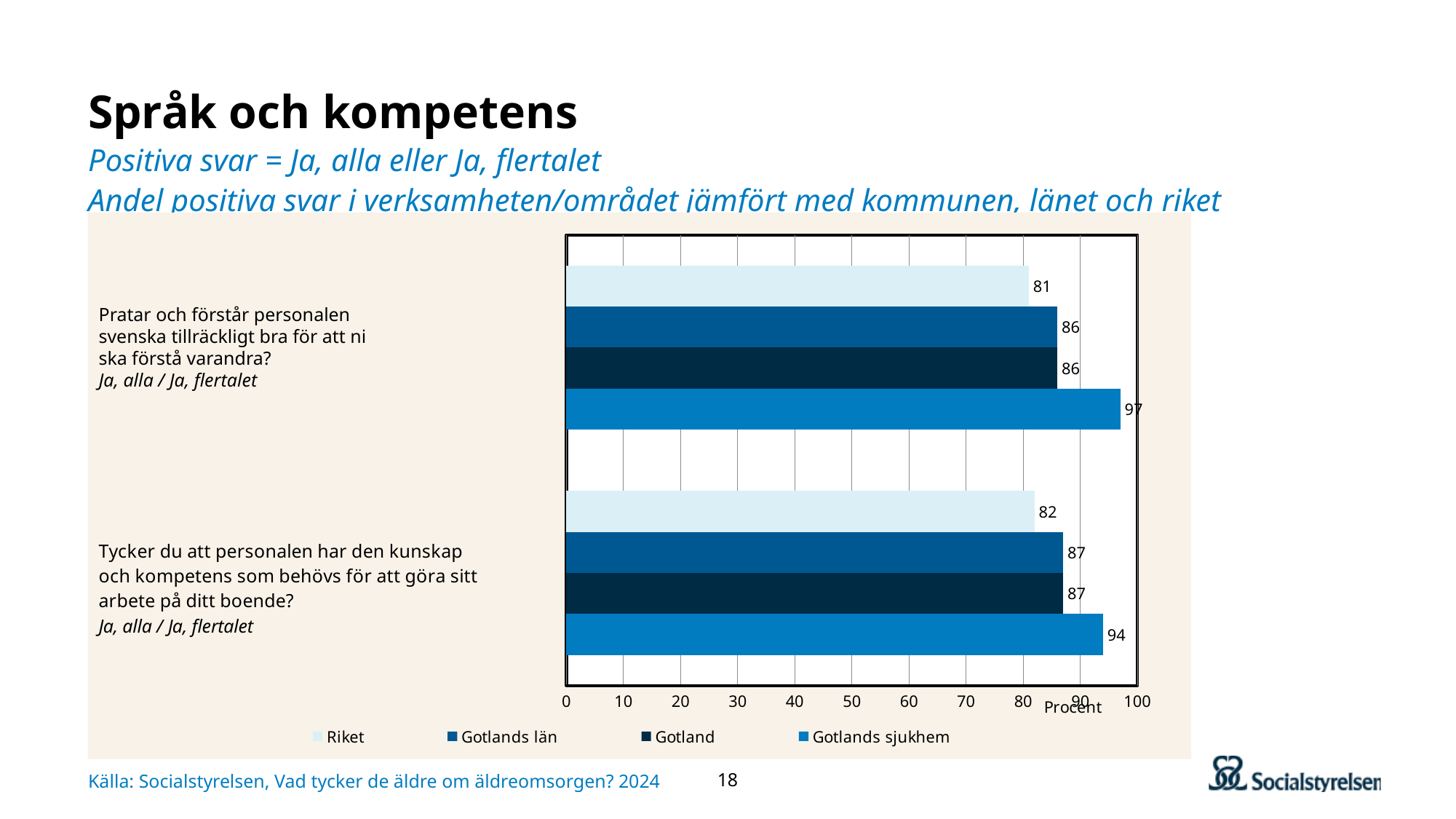
What is the difference between Gotlands sjukhem and Riket on the question about whether staff speak and understand Swedish well enough? 16 What is the value for Gotland on the question about staff knowledge and competence? 87 Which is larger: the Gotlands sjukhem value for the Swedish-language question or the Gotlands sjukhem value for the knowledge and competence question? The Swedish-language question (97) What unit is shown on the horizontal axis of the chart? Procent How many series does the legend list? 4 What is the value for Gotlands sjukhem on the question 'Pratar och förstår personalen svenska tillräckligt bra för att ni ska förstå varandra?' 97 What is the value for Riket on the question 'Tycker du att personalen har den kunskap och kompetens som behövs för att göra sitt arbete på ditt boende?' 82 Which series has the highest value on the question about staff knowledge and competence? Gotlands sjukhem What kind of chart is shown on the slide? Bar chart What is the value for Gotlands län on the question about whether staff speak and understand Swedish well enough? 86 Which series has the lowest value on the question about whether staff speak and understand Swedish well enough? Riket How many question categories are plotted in the chart? 2